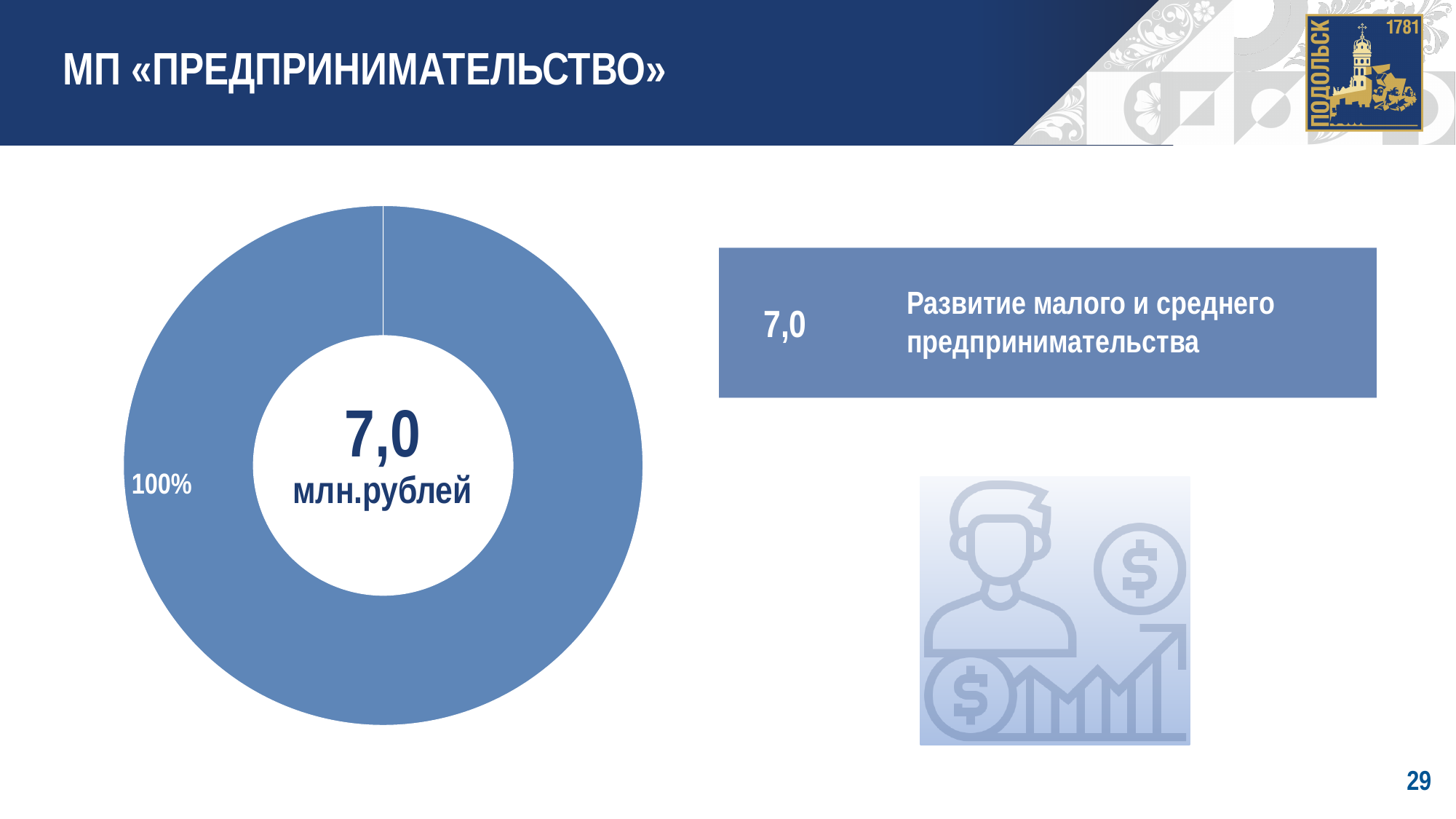
How many slices does the donut chart have? 1 Which category makes up the whole donut chart? Развитие малого и среднего предпринимательства What value is shown for «Развитие малого и среднего предпринимательства»? 7,0 What total value is printed in the centre of the donut chart? 7,0 млн.рублей What is the title of the slide containing the donut chart? МП «ПРЕДПРИНИМАТЕЛЬСТВО» What unit is given for the value in the centre of the donut chart? млн.рублей What share of the donut chart does the single slice represent? 100% What kind of chart is shown on the slide? pie chart (donut)